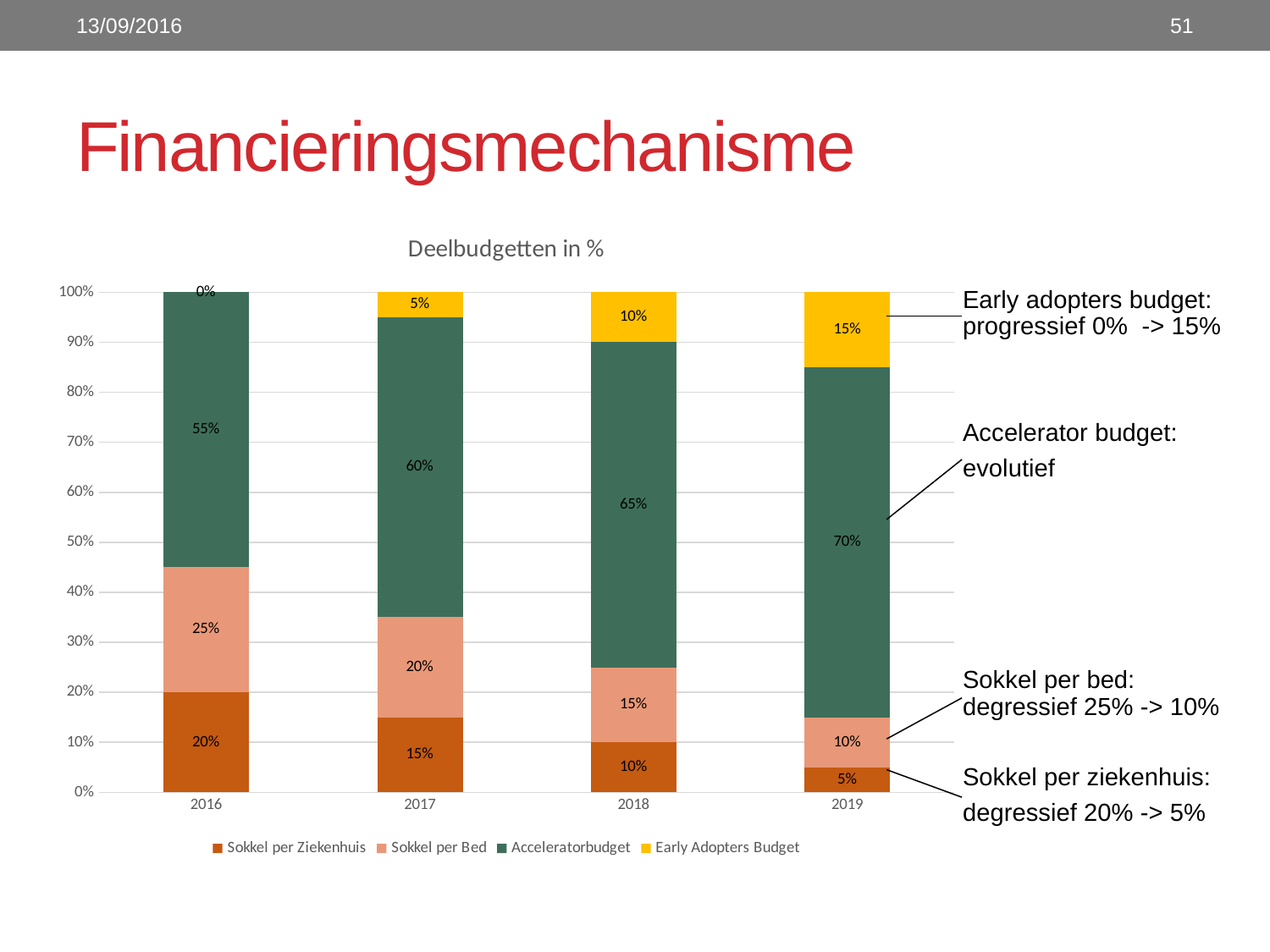
What is the value for Early Adopters Budget in 2019? 15% What kind of chart is shown? Stacked bar chart How many series does the legend list? 4 Which is larger: Sokkel per Bed in 2017 or Early Adopters Budget in 2017? Sokkel per Bed in 2017 What is the value for Sokkel per Ziekenhuis in 2017? 15% What is the difference between the Acceleratorbudget value in 2019 and in 2016? 15% What is the value for Sokkel per Bed in 2016? 25% In which year is the Sokkel per Ziekenhuis share lowest? 2019 Does the Early Adopters Budget share rise or fall from 2016 to 2019? Rise How many years are shown on the x axis? 4 In which year is the Acceleratorbudget share highest? 2019 What is the value for Acceleratorbudget in 2018? 65%